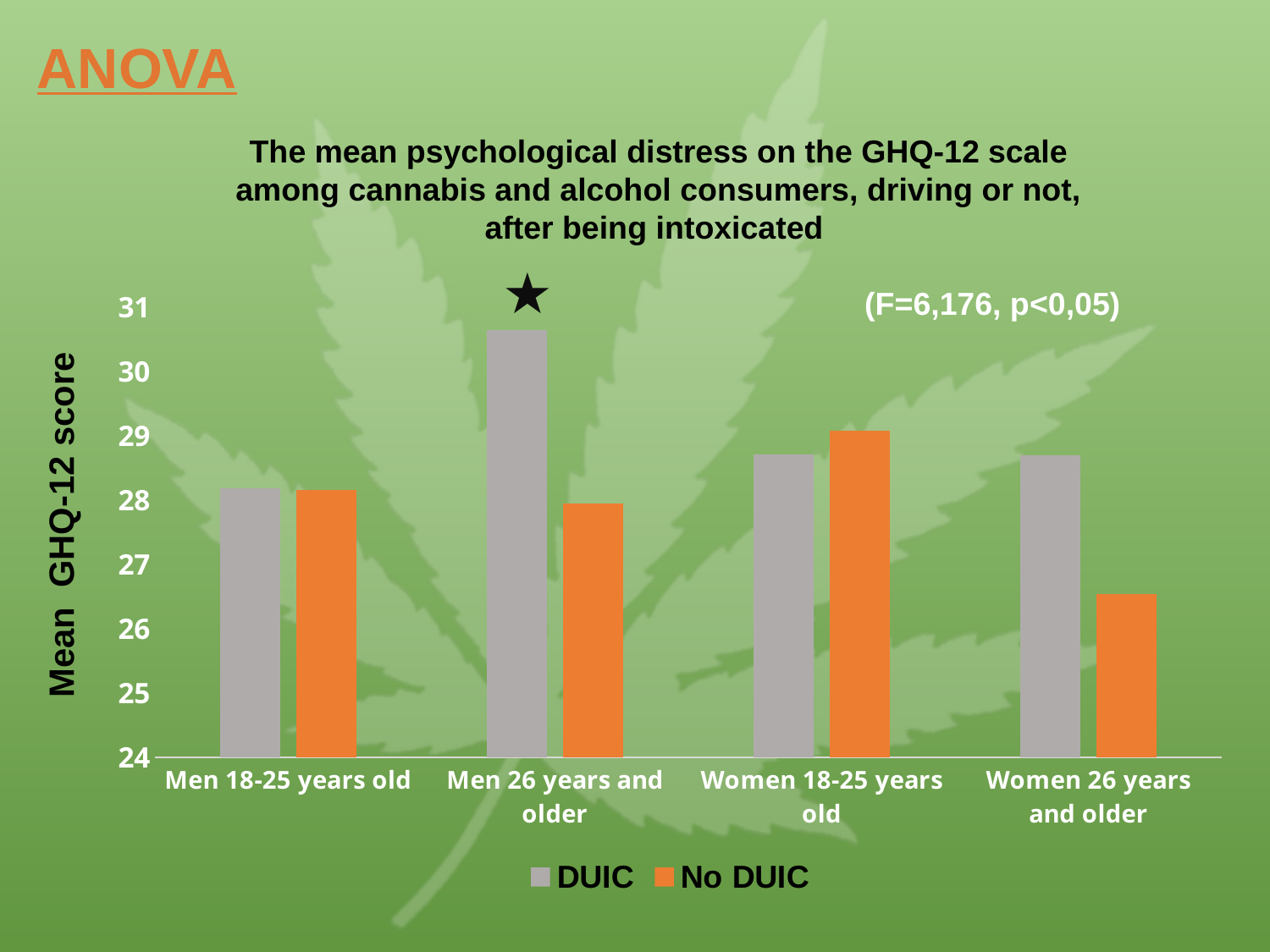
Which category has the highest DUIC value? Men 26 years and older What colour represents the No DUIC series in the chart? orange Which category has the lowest No DUIC value? Women 26 years and older For Women 26 years and older, which is larger: the DUIC value or the No DUIC value? DUIC Is the DUIC value for Men 26 years and older greater or less than 30? greater What kind of chart is shown on the slide? bar chart Is the No DUIC value for Women 26 years and older greater or less than 27? less How many categories are shown on the x axis of the chart? 4 For Men 26 years and older, which is larger: the DUIC value or the No DUIC value? DUIC How many series does the chart's legend list? 2